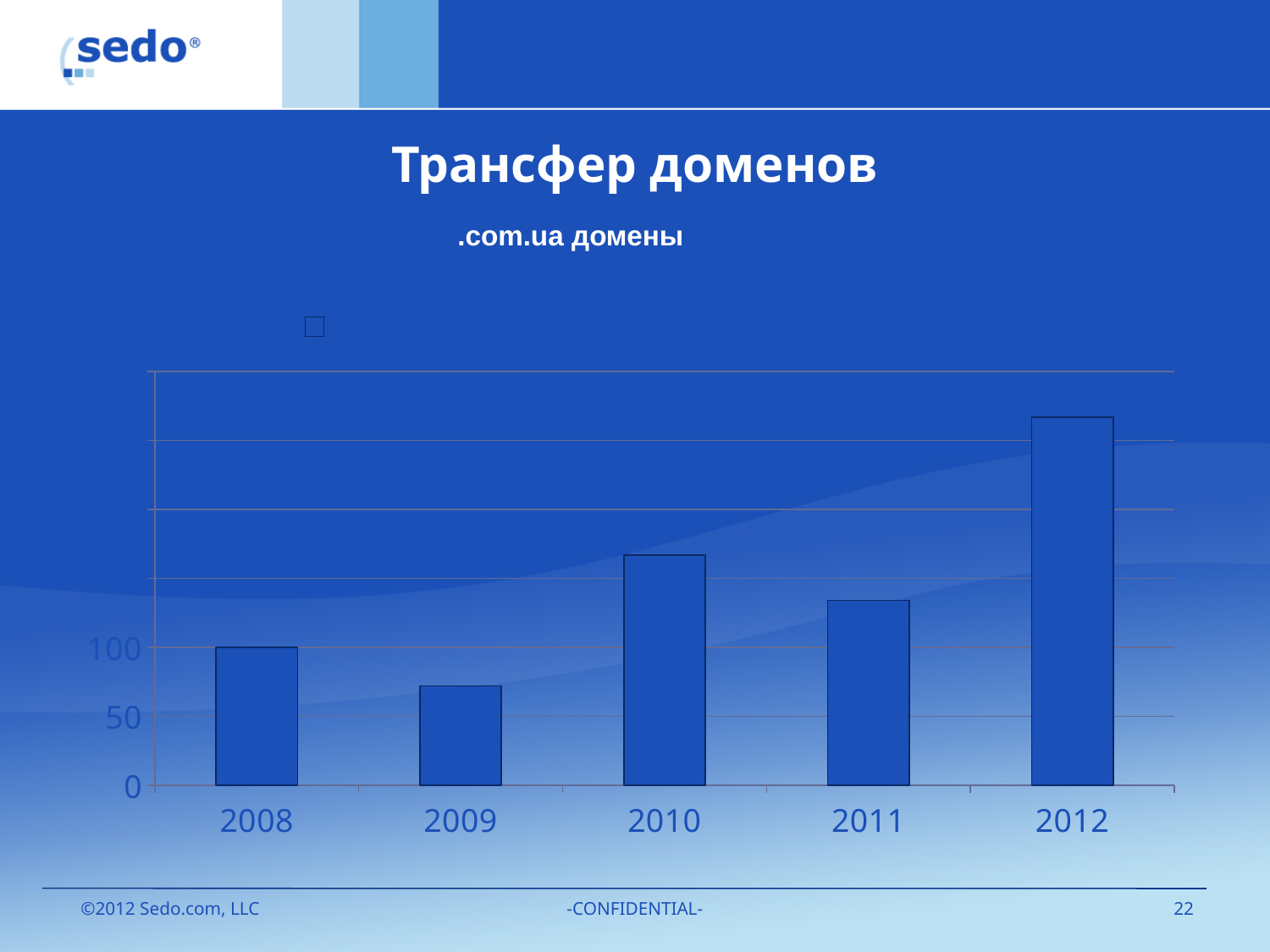
What is the title of the chart? .com.ua домены Is the value for 2009 greater or less than 100? less Which year has the lowest bar in the chart? 2009 Does the value fall or rise from 2008 to 2009? fall Which year has the highest bar in the chart? 2012 Is the value for 2011 greater or less than 100? greater Which year has the larger value, 2012 or 2008? 2012 Is the value for 2009 greater or less than 50? greater How many years are shown on the x axis of the chart? 5 Which year has the larger value, 2010 or 2011? 2010 What is the value for 2008 in the chart? 100 What kind of chart is shown on the slide? bar chart